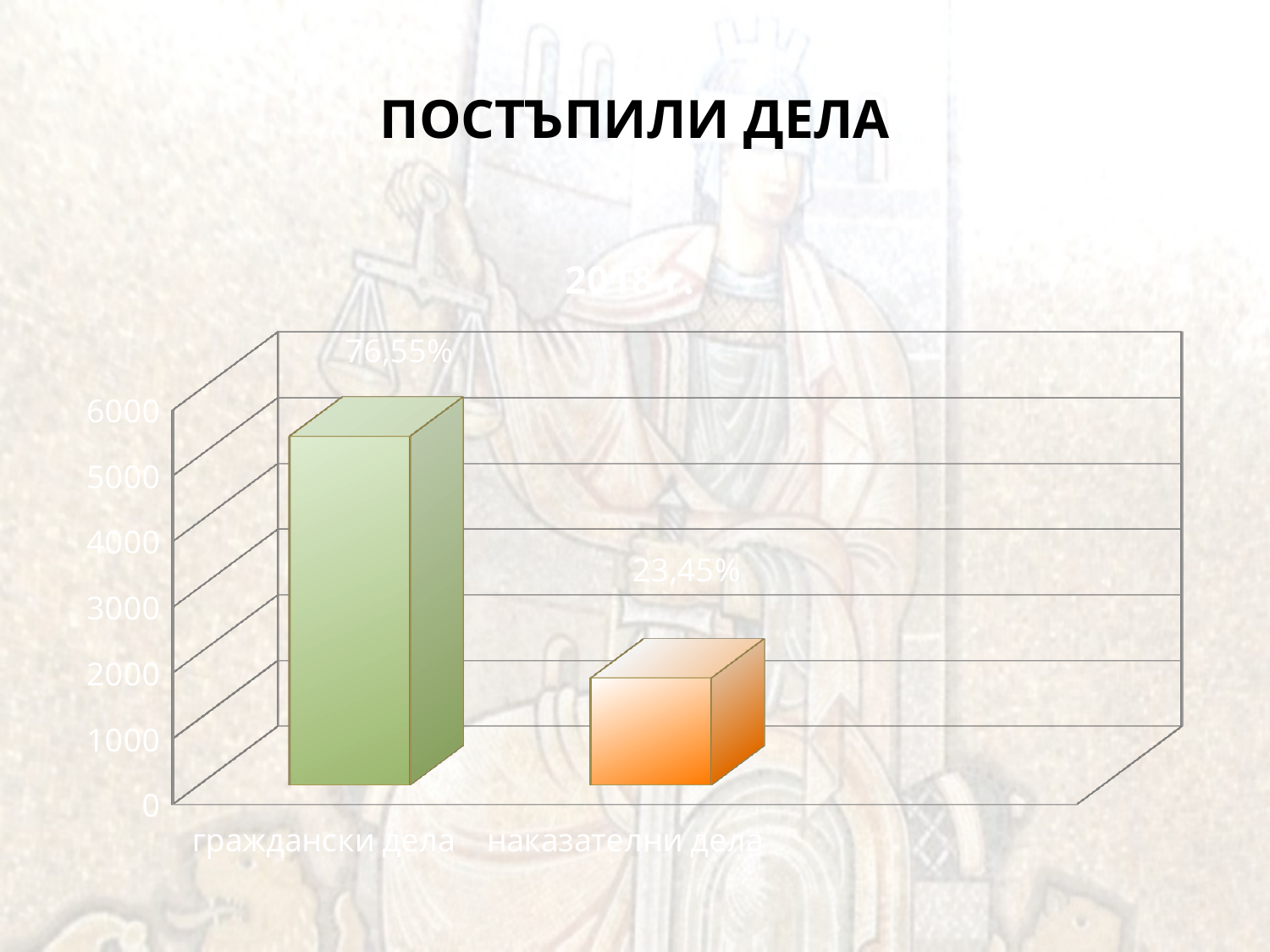
How many categories are shown on the x axis? 2 Which category has the highest bar? граждански дела What is the title of the chart? 2018 г. Is the value for наказателни дела greater or less than 3000? less What is the difference between the percentage labels for граждански дела and наказателни дела? 53,10% Which category has the lowest bar? наказателни дела What is the title of the slide? ПОСТЪПИЛИ ДЕЛА Is the value for граждански дела greater or less than 4000? greater What data label is shown on the bar for граждански дела? 76,55% Which is larger, the value for граждански дела or the value for наказателни дела? граждански дела What kind of chart is shown on the slide? bar chart What data label is shown on the bar for наказателни дела? 23,45%